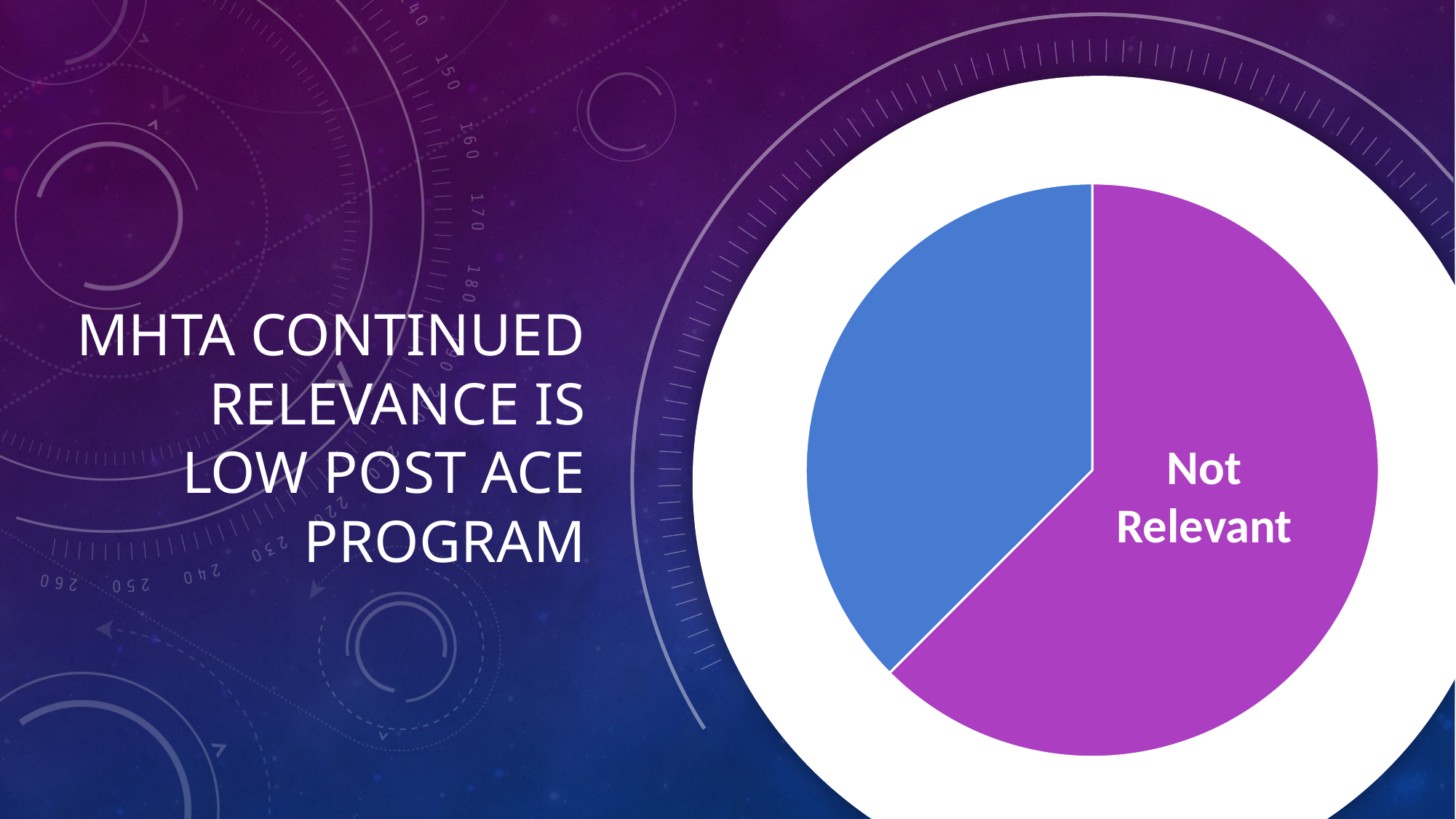
Which is larger in the pie chart: the Not Relevant slice or the blue slice? Not Relevant Which slice of the pie chart is the largest? Not Relevant What kind of chart is shown on the slide? Pie chart Which slice of the pie chart carries a text label? Not Relevant How many slices does the pie chart have? 2 What colour is the Not Relevant slice in the pie chart? Purple Does the Not Relevant slice take up more or less than half of the pie? More